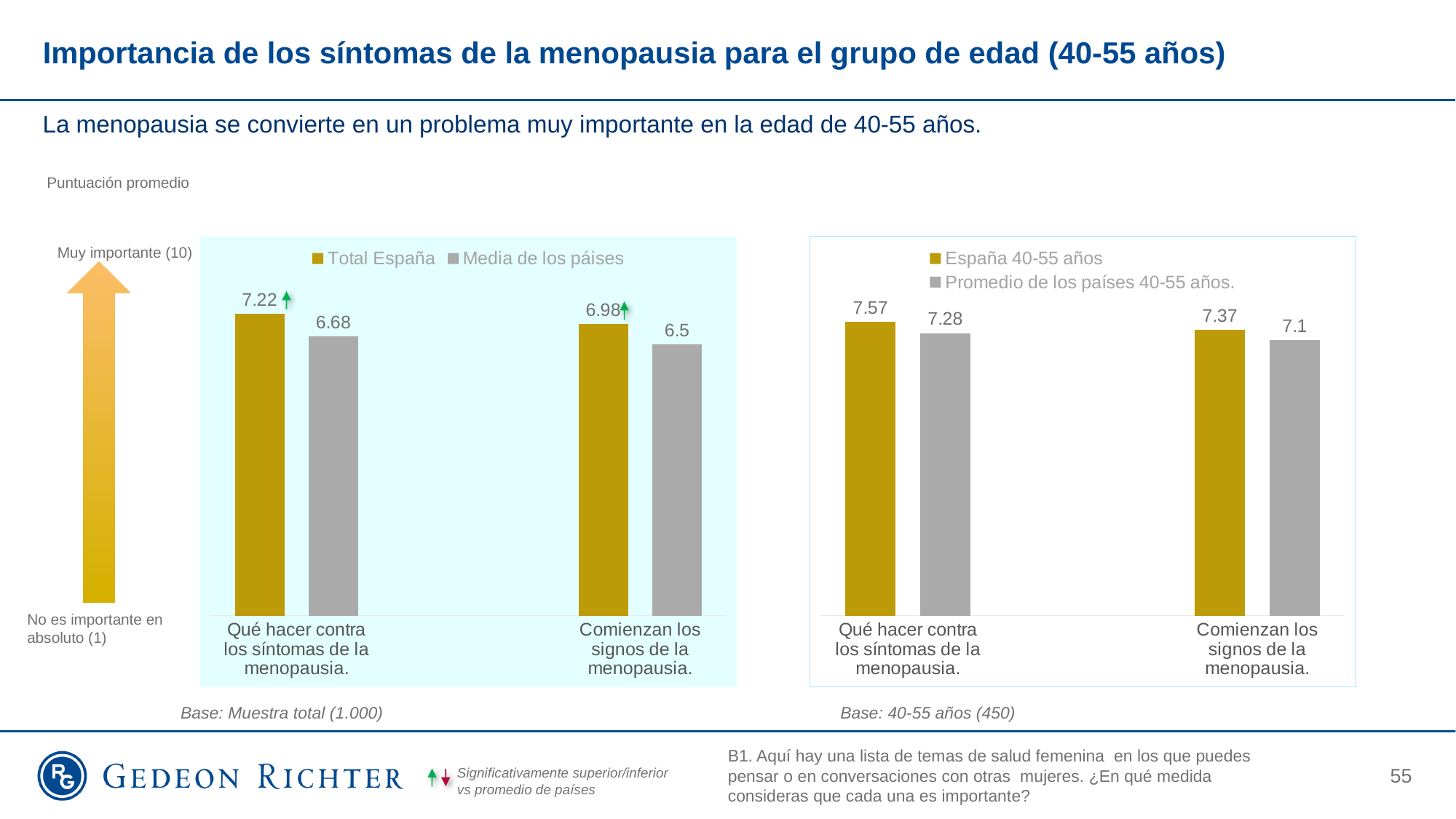
In the left chart, what is the difference between Total España and Media de los países for "Qué hacer contra los síntomas de la menopausia"? 0.54 In the right chart, what is the España 40-55 años value for "Comienzan los signos de la menopausia"? 7.37 In the right chart, which category has the highest España 40-55 años value? Qué hacer contra los síntomas de la menopausia. How many categories are shown on the x axis of the left chart? 2 In the right chart, what is the difference between España 40-55 años and Promedio de los países 40-55 años for "Comienzan los signos de la menopausia"? 0.27 In the left chart, which bar has the lowest value? Media de los países for Comienzan los signos de la menopausia (6.5) In the left chart, what is the Media de los países value for "Comienzan los signos de la menopausia"? 6.5 In the left chart, which is larger for "Comienzan los signos de la menopausia": Total España or Media de los países? Total España How many series does the legend of the right chart list? 2 In the left chart, what is the Total España value for "Qué hacer contra los síntomas de la menopausia"? 7.22 In the right chart, what is the Promedio de los países 40-55 años value for "Qué hacer contra los síntomas de la menopausia"? 7.28 What type of chart is the right chart? Bar chart